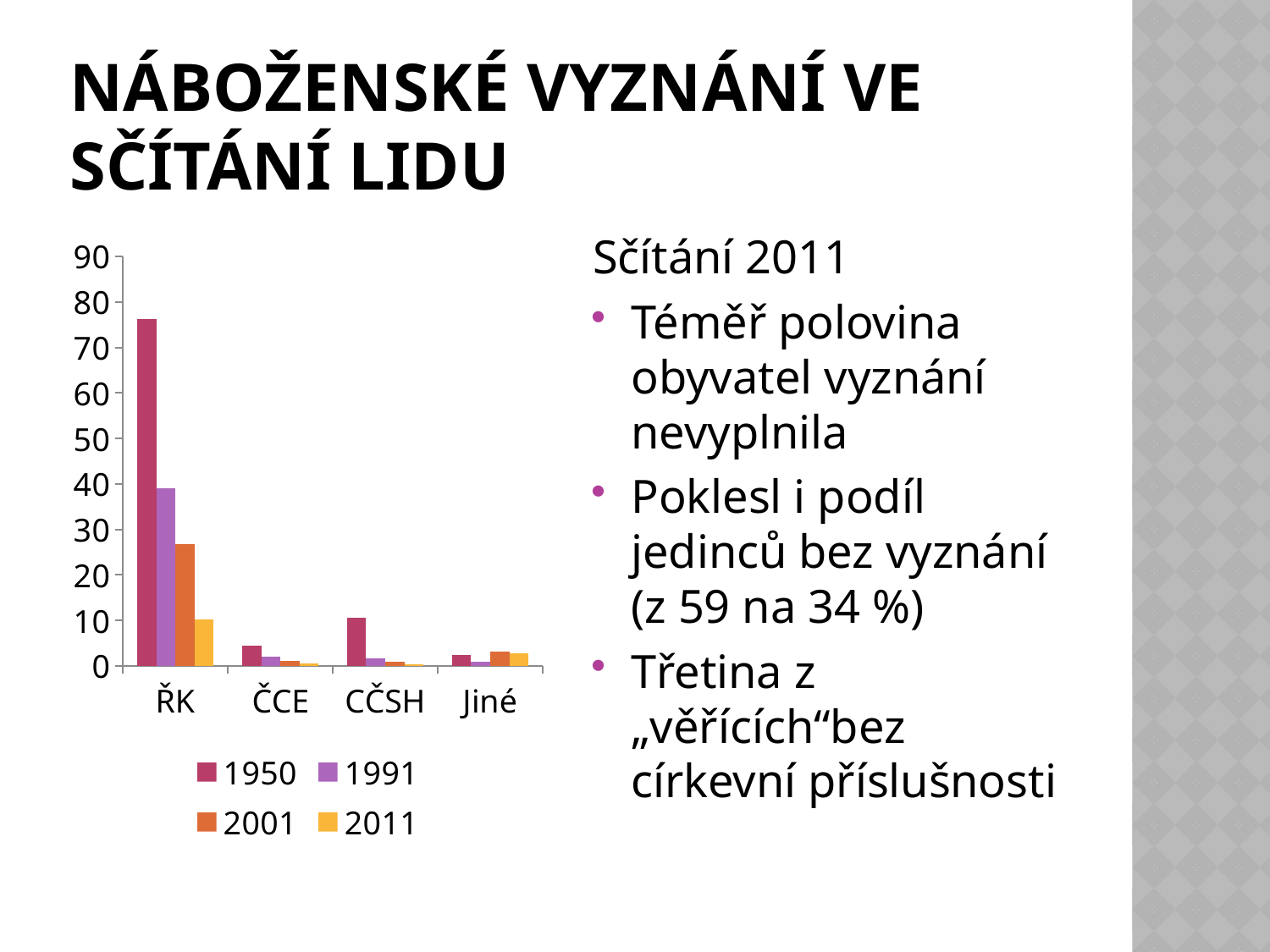
How many series does the chart legend list? 4 Is the value for CČSH in 1950 greater or less than 20? less Which is larger for 1950: the value for ŘK or the value for CČSH? ŘK Is the value for ŘK in 1950 greater or less than 70? greater What kind of chart is shown on the slide? bar chart Is the value for ŘK in 1991 greater or less than 30? greater Which category has the highest bar in the chart? ŘK For the ŘK category, which year has the tallest bar? 1950 How many categories are shown on the x axis of the chart? 4 Do the values for ŘK rise or fall from 1950 to 2011? fall For the ŘK category, which year has the shortest bar? 2011